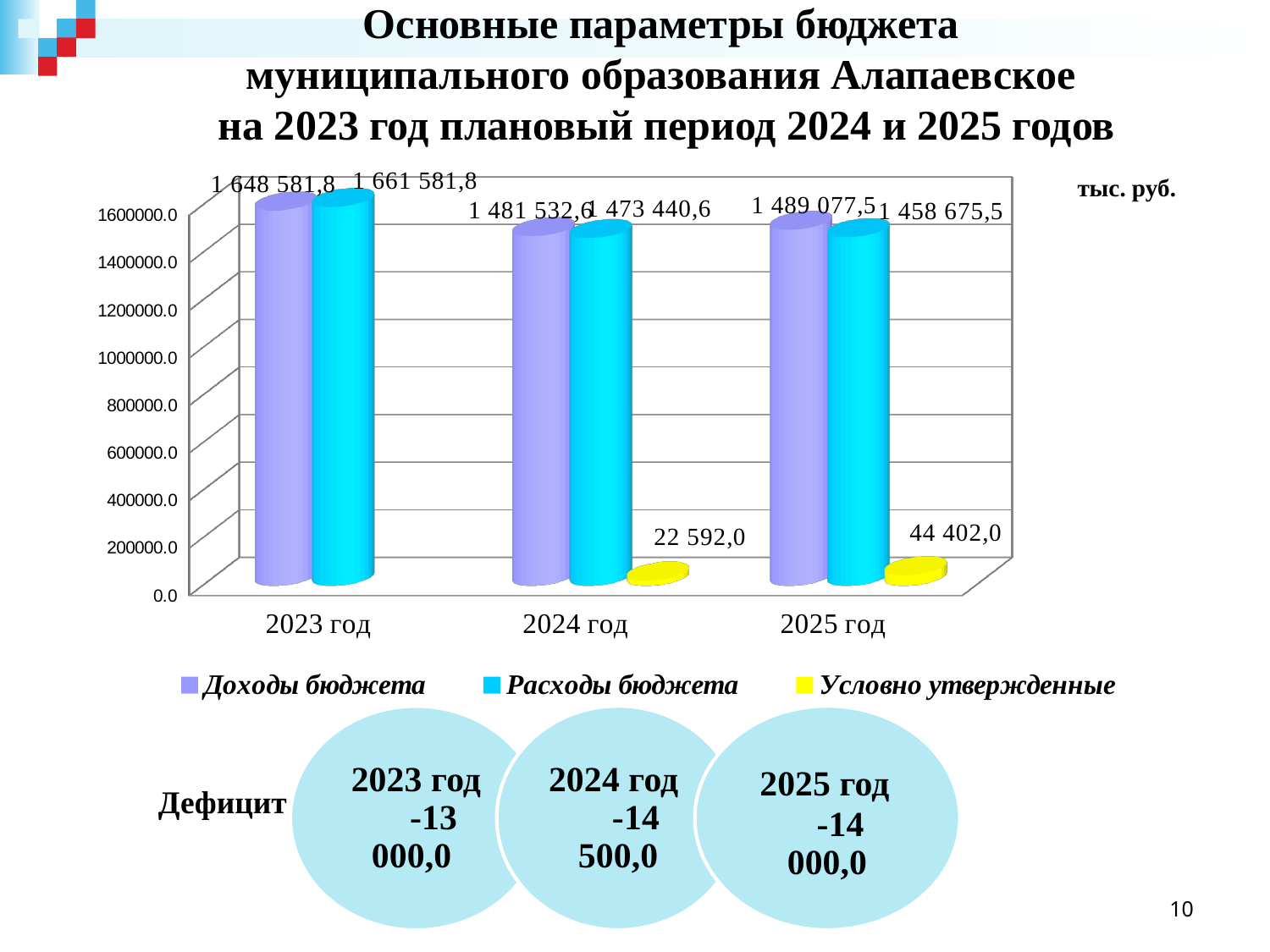
Is the value of Условно утвержденные for 2025 год greater or less than 200000.0? less In which year is Доходы бюджета the highest? 2023 год What is the value of Расходы бюджета for 2025 год? 1 458 675,5 In 2024 год, which is larger: Доходы бюджета or Расходы бюджета? Доходы бюджета How many series does the chart legend list? 3 What is the difference between Расходы бюджета and Доходы бюджета in 2023 год? 13 000,0 What is the difference between Условно утвержденные in 2025 год and 2024 год? 21 810,0 Does Расходы бюджета rise or fall from 2023 год to 2025 год? fall How many years are shown on the x axis of the chart? 3 What is the value of Условно утвержденные for 2024 год? 22 592,0 In which year is Расходы бюджета the lowest? 2025 год What is the value of Доходы бюджета for 2023 год? 1 648 581,8